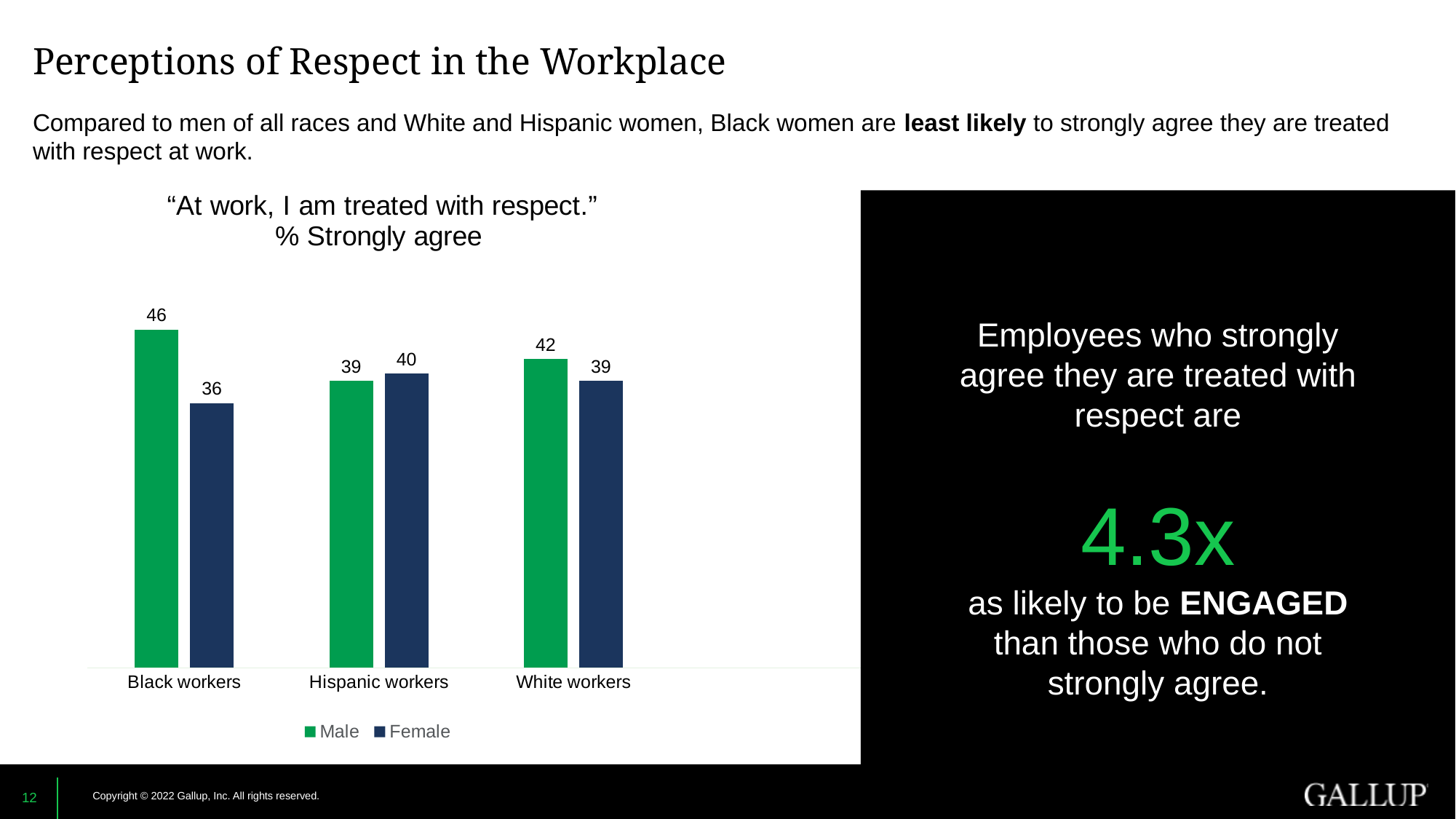
Which is larger for Hispanic workers, the Male value or the Female value? Female How many series does the legend list? 2 What is the value for Female among Black workers? 36 How many worker groups are shown on the x axis? 3 What is the value for Female among Hispanic workers? 40 What is the difference between the Male and Female values for Black workers? 10 Which colour represents the Female series in the chart? Dark blue What kind of chart is shown on the slide? Bar chart Which group has the lowest Female value? Black workers What is the value for Male among Black workers? 46 What is the value for Male among White workers? 42 Which group has the highest Male value? Black workers